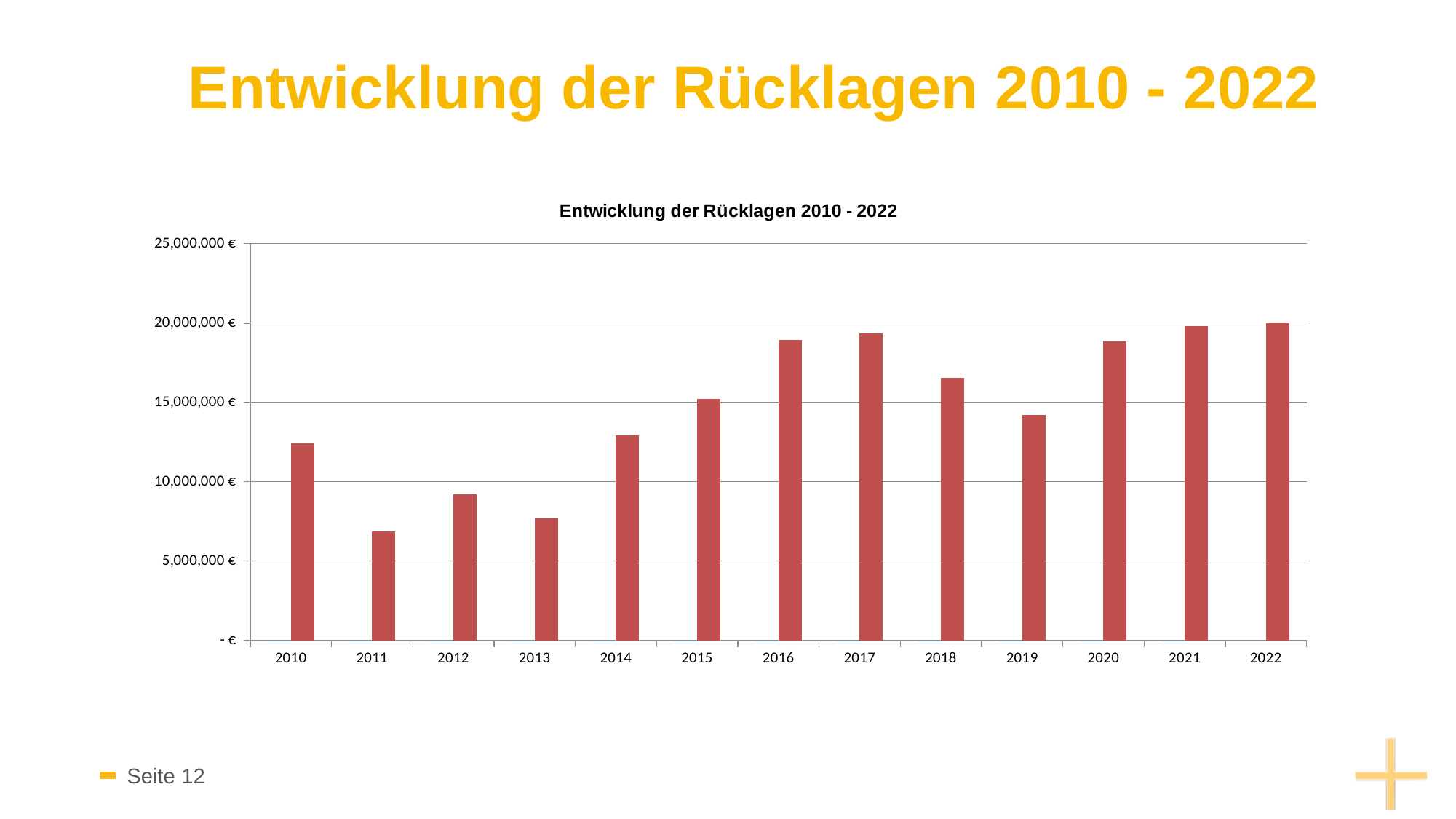
What is the title of the chart? Entwicklung der Rücklagen 2010 - 2022 Is the value for 2010 greater or less than 10,000,000 €? greater Do the values rise or fall from 2013 to 2017? rise Which is larger, the value for 2012 or the value for 2013? 2012 What kind of chart is shown on the slide? bar chart Is the value for 2016 greater or less than 15,000,000 €? greater Is the value for 2011 greater or less than 10,000,000 €? less Which is larger, the value for 2017 or the value for 2018? 2017 What colour are the bars in the chart? red How many years are shown on the x axis of the chart? 13 Which year has the lowest value in the chart? 2011